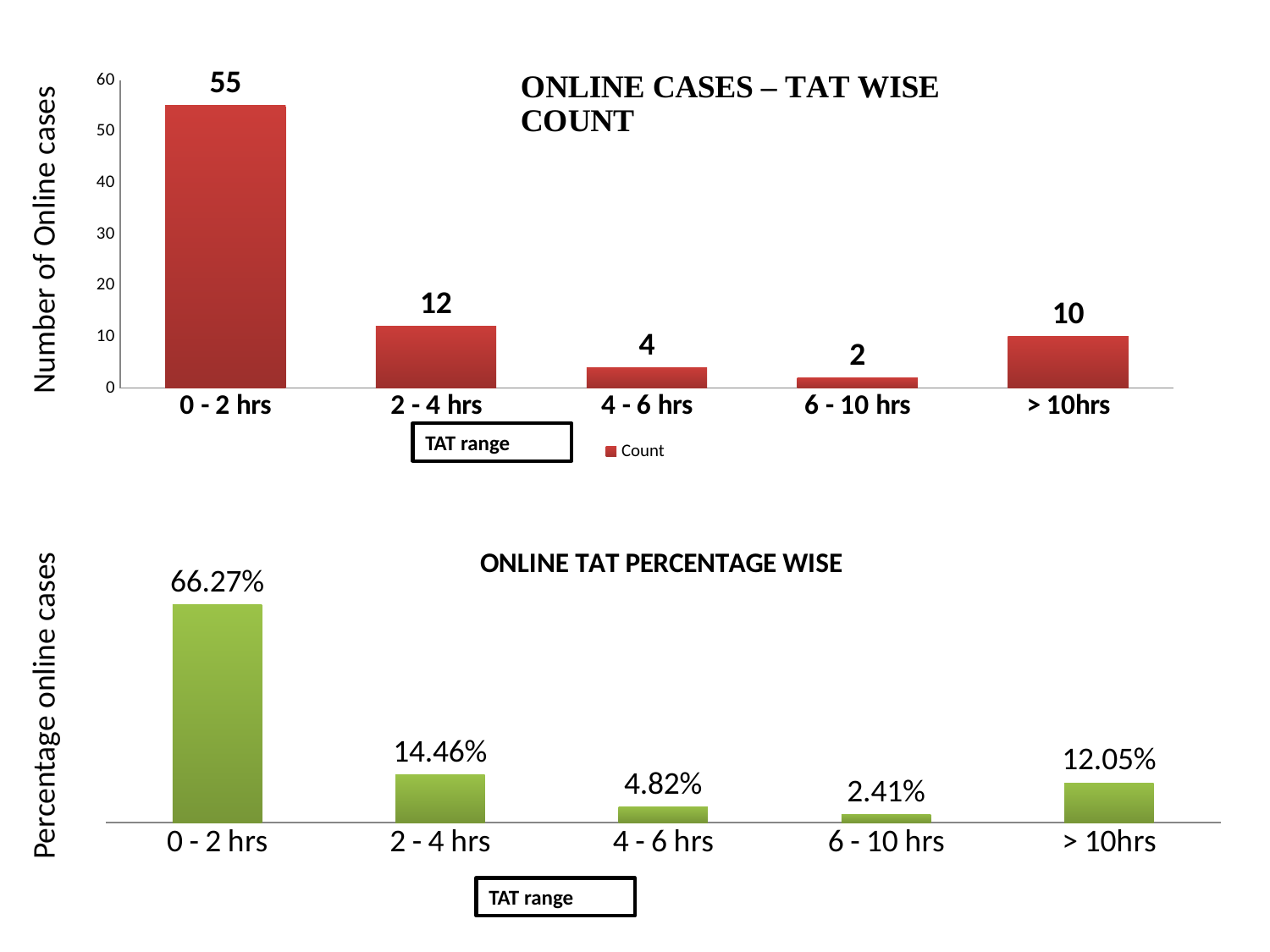
In the 'ONLINE CASES – TAT WISE COUNT' chart, how many series does the legend list? 1 In the 'ONLINE TAT PERCENTAGE WISE' chart, what is the percentage for the > 10hrs TAT range? 12.05% In the 'ONLINE TAT PERCENTAGE WISE' chart, what is the percentage for the 4 - 6 hrs TAT range? 4.82% In the 'ONLINE CASES – TAT WISE COUNT' chart, which TAT range has the lowest count? 6 - 10 hrs In the 'ONLINE CASES – TAT WISE COUNT' chart, what is the difference between the counts for 0 - 2 hrs and > 10hrs? 45 In the 'ONLINE CASES – TAT WISE COUNT' chart, what is the label of the y axis? Number of Online cases In the 'ONLINE TAT PERCENTAGE WISE' chart, which TAT range has the lowest percentage? 6 - 10 hrs In the 'ONLINE CASES – TAT WISE COUNT' chart, which has a larger count, 4 - 6 hrs or > 10hrs? > 10hrs In the 'ONLINE CASES – TAT WISE COUNT' chart, how many TAT range categories are shown? 5 What type of chart is the 'ONLINE TAT PERCENTAGE WISE' chart? Bar chart In the 'ONLINE CASES – TAT WISE COUNT' chart, which TAT range has the highest count? 0 - 2 hrs In the 'ONLINE CASES – TAT WISE COUNT' chart, what is the count for the 2 - 4 hrs TAT range? 12